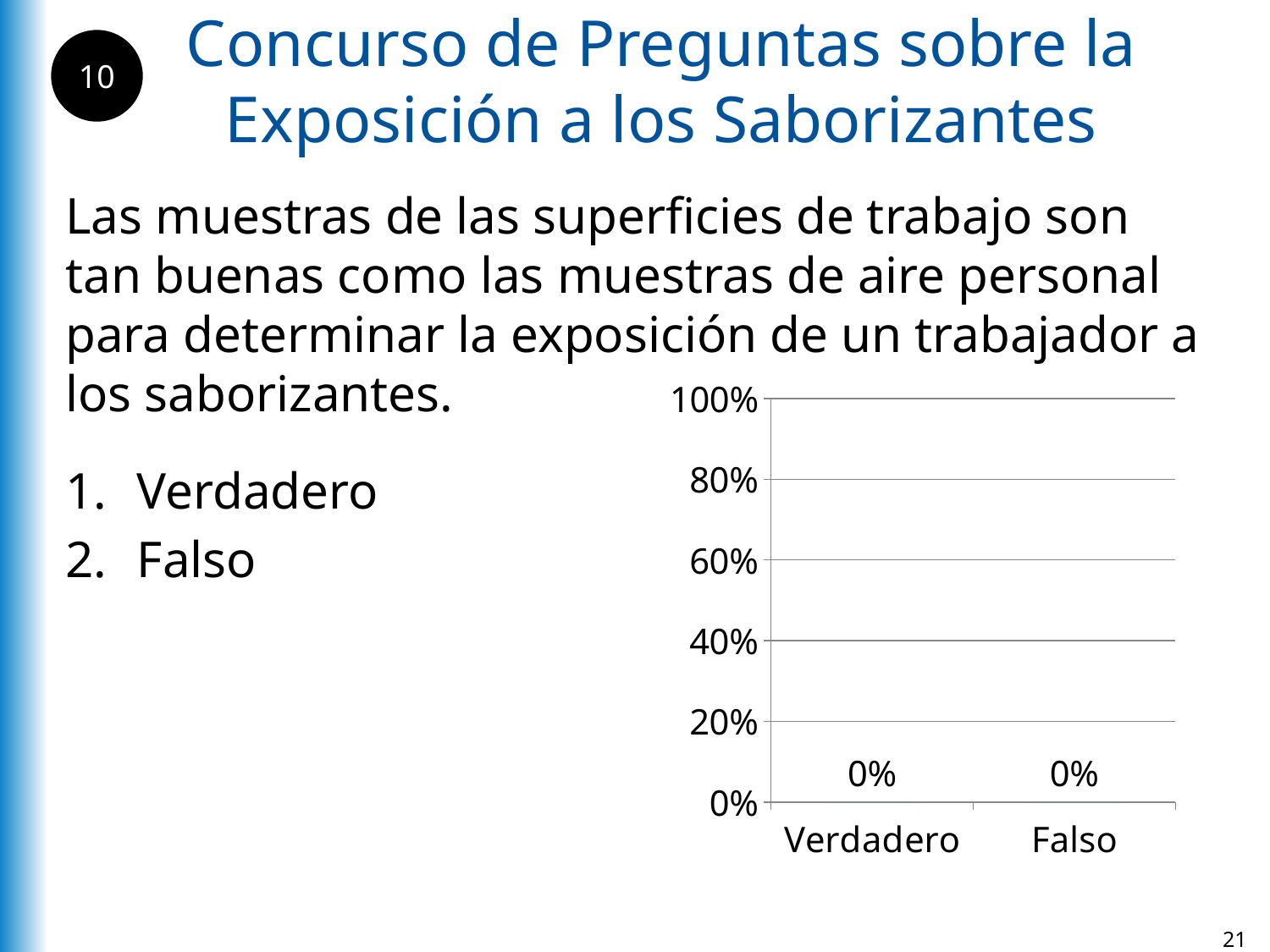
What are the category labels on the x axis of the chart? Verdadero, Falso What is the value for Falso? 0% What is the highest value shown on the y axis of the chart? 100% How many categories are shown on the x axis of the chart? 2 Is the value for Falso greater or less than 20%? less What is the total of the values for Verdadero and Falso? 0% What is the value for Verdadero? 0% What kind of chart is shown on the slide? bar chart Is the value for Verdadero greater or less than 20%? less What is the difference between the values for Verdadero and Falso? 0%